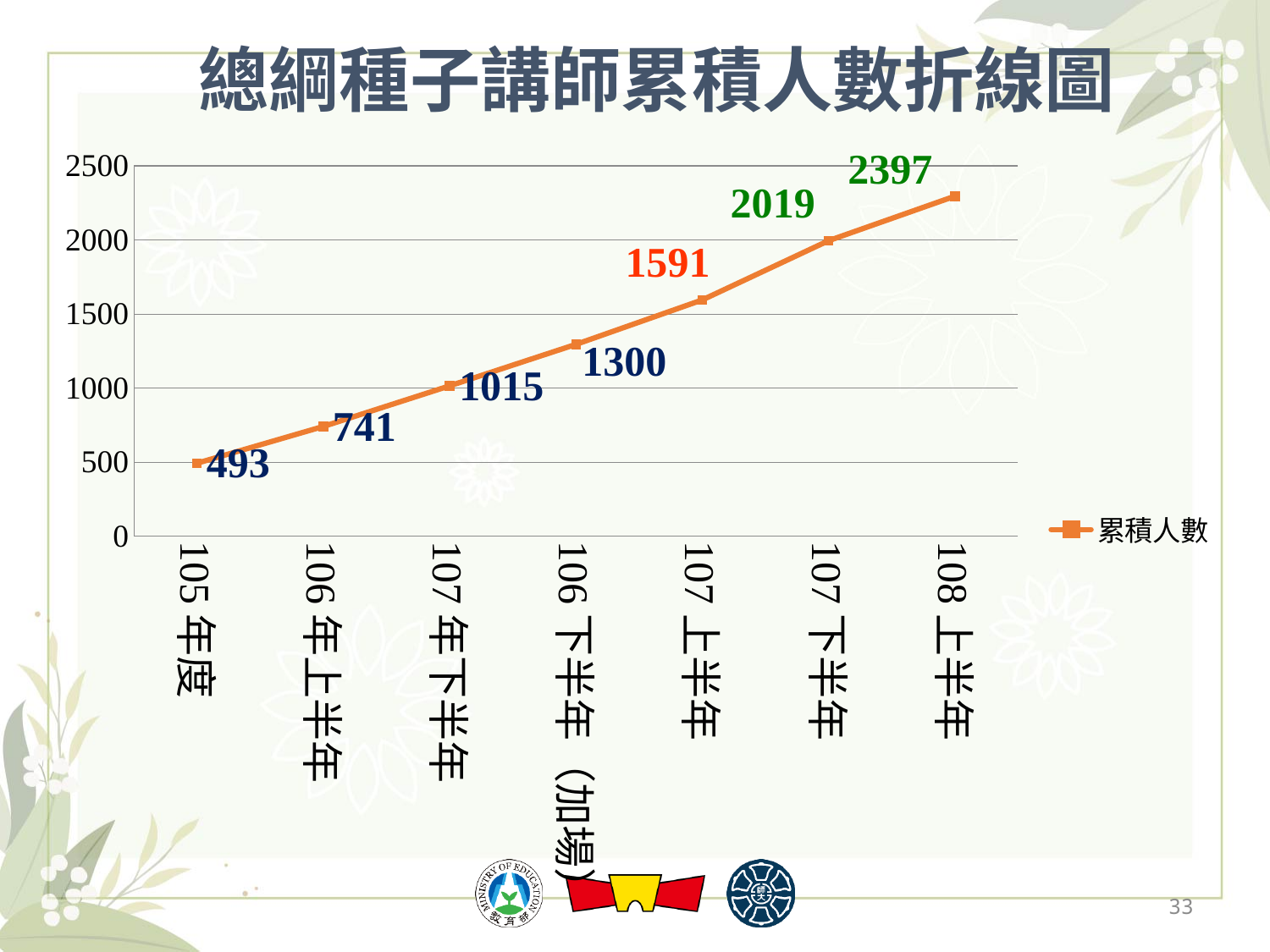
Which category has the highest value? 108 上半年 What is the value for 108 上半年? 2397 Which is larger, the value for 106 下半年(加場) or the value for 106 年上半年? 106 下半年(加場) What is the value for 107 上半年? 1591 What is the value for 106 年上半年? 741 How many data points are plotted on the line? 7 What is the value for 105 年度? 493 Do the values rise or fall along the x axis? rise Which category has the lowest value? 105 年度 What kind of chart is shown on the slide? line chart What is the difference between the values for 107 下半年 and 107 上半年? 428 What series name does the legend show? 累積人數